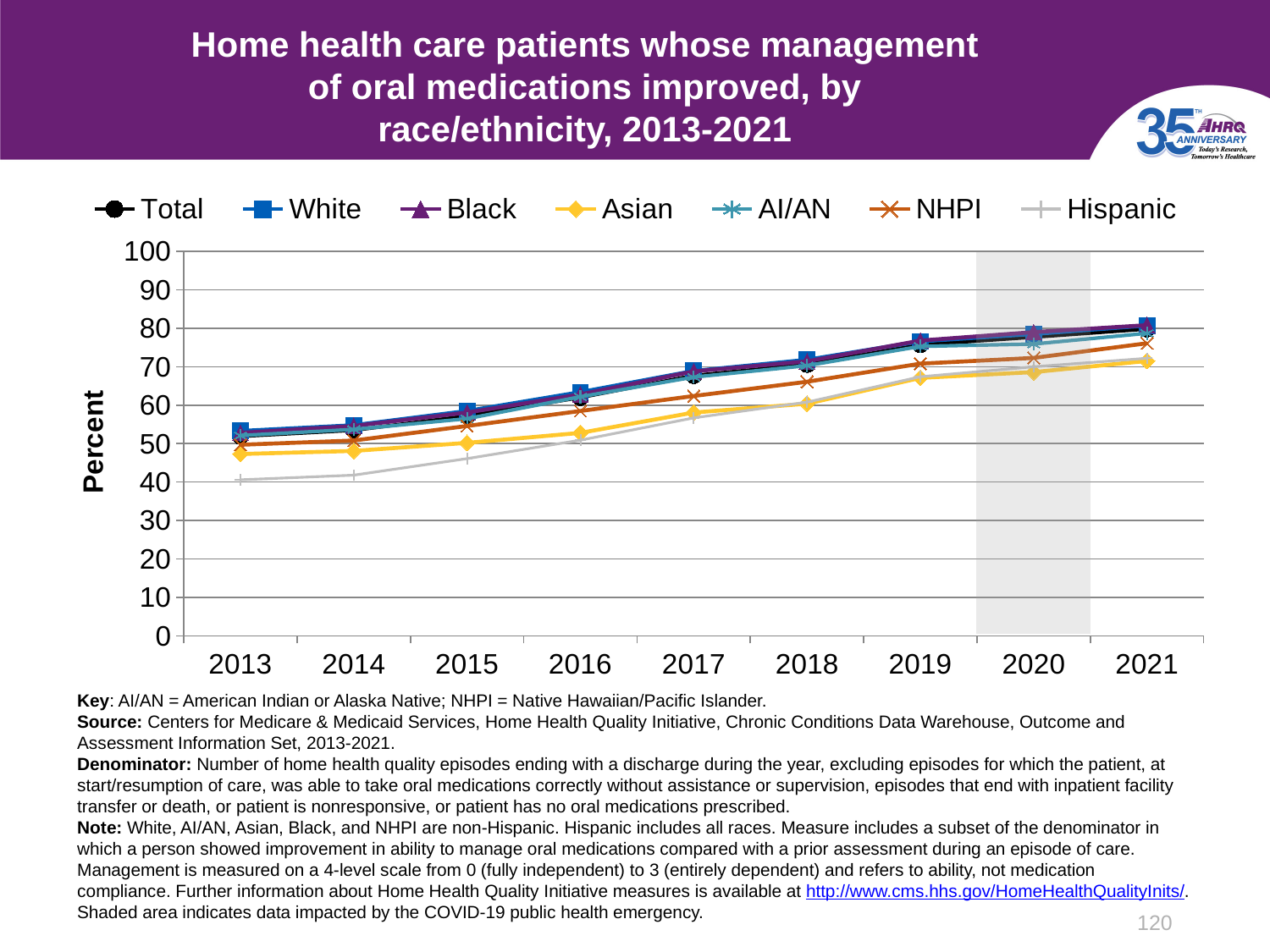
Is the value for NHPI in 2021 greater or less than 70? greater Do the values for the Total series rise or fall from 2013 to 2021? rise In 2013, which is larger, the value for White or the value for Hispanic? White How many series does the legend list? 7 Which race/ethnicity group had the lowest value in 2013? Hispanic Is the value for Asian in 2017 greater or less than 60? less Is the value for White in 2019 greater or less than 70? greater How many years are shown on the x axis? 9 What does the shaded area on the chart indicate? Data impacted by the COVID-19 public health emergency What kind of chart is shown on the slide? line chart